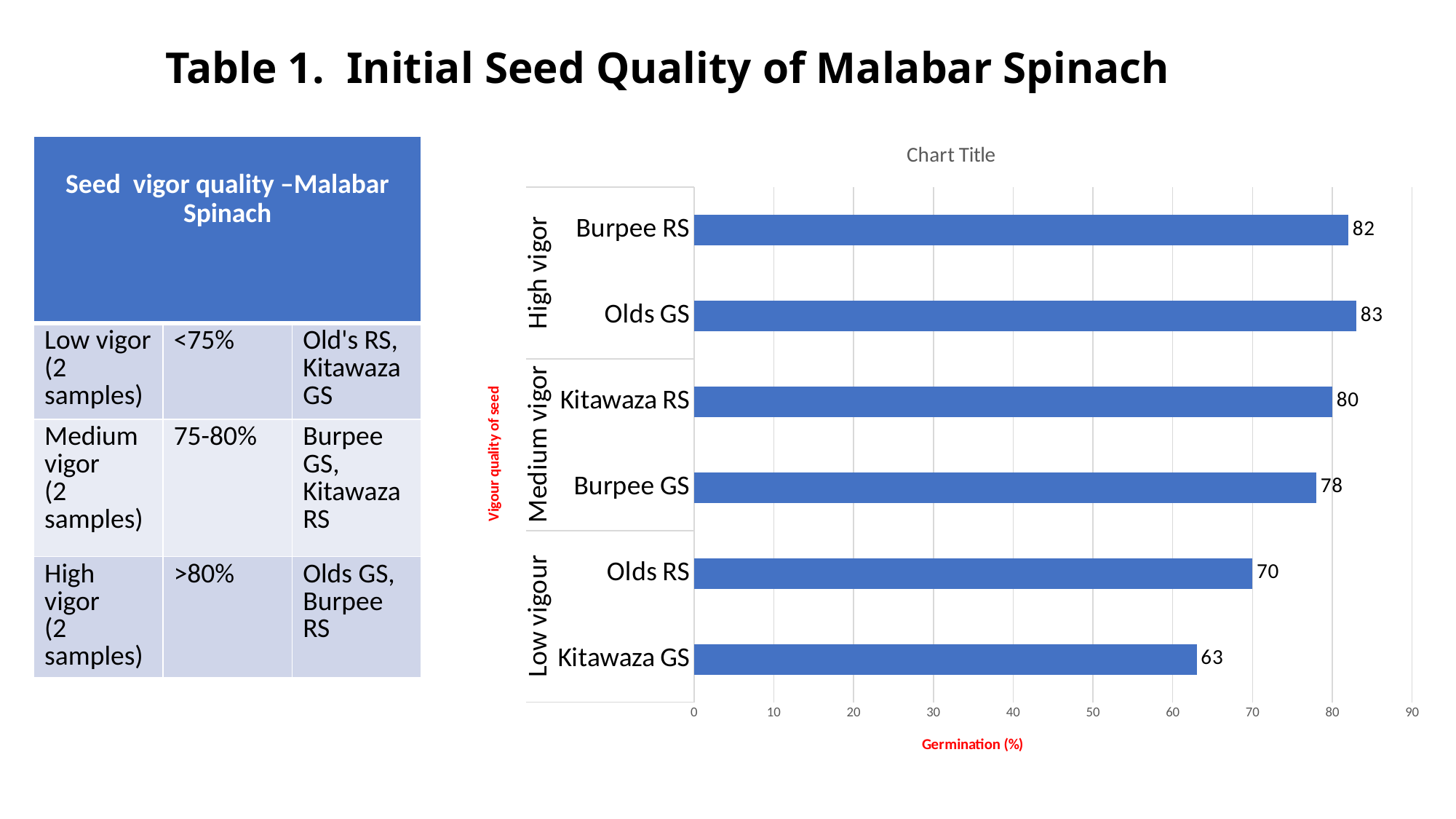
Which seed sample has the highest germination (%)? Olds GS Is the germination (%) value for Kitawaza GS greater or less than 70? less Which seed sample has the lowest germination (%)? Kitawaza GS What is the difference in germination (%) between Olds GS and Kitawaza GS? 20 What is the label of the horizontal axis of the chart? Germination (%) What is the difference in germination (%) between Kitawaza RS and Burpee GS? 2 What is the germination (%) value for Olds RS? 70 How many seed samples are plotted in the chart? 6 What is the germination (%) value for Burpee RS? 82 What is the germination (%) value for Kitawaza GS? 63 Which has a higher germination (%), Burpee GS or Olds RS? Burpee GS What kind of chart is shown on the slide? bar chart